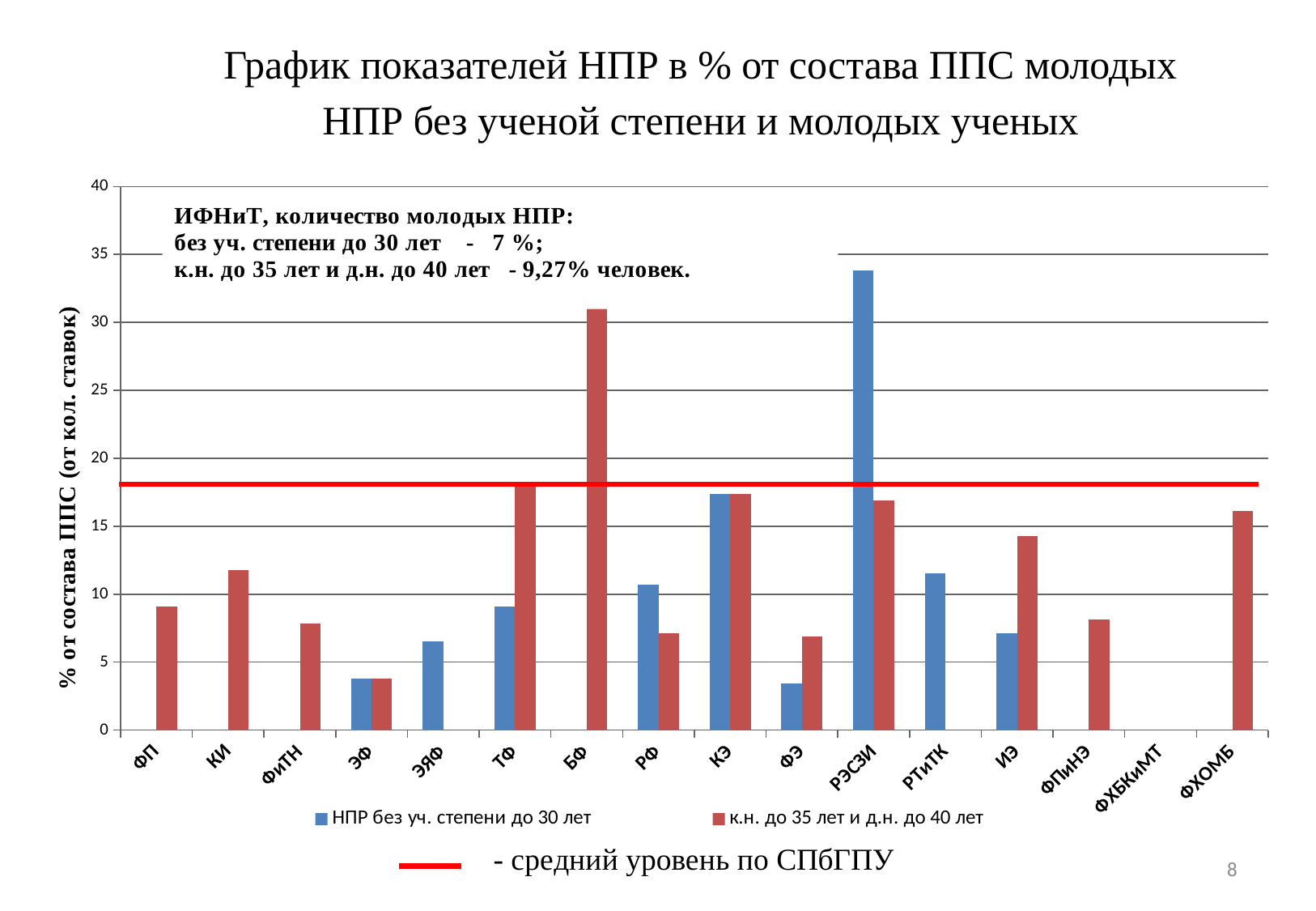
What kind of chart is shown on the slide? bar chart For РФ, which series has the larger value: 'НПР без уч. степени до 30 лет' or 'к.н. до 35 лет и д.н. до 40 лет'? НПР без уч. степени до 30 лет Is the value for РЭСЗИ in the series 'НПР без уч. степени до 30 лет' greater or less than 30? greater Is the value for ФХОМБ in the series 'к.н. до 35 лет и д.н. до 40 лет' greater or less than 20? less Which category has the highest value for the series 'к.н. до 35 лет и д.н. до 40 лет'? БФ Is the value for КИ in the series 'к.н. до 35 лет и д.н. до 40 лет' greater or less than 10? greater What does the red horizontal line on the chart represent, according to the legend? средний уровень по СПбГПУ For ТФ, which series has the larger value: 'НПР без уч. степени до 30 лет' or 'к.н. до 35 лет и д.н. до 40 лет'? к.н. до 35 лет и д.н. до 40 лет How many series does the legend below the chart list? 2 How many categories are shown along the x axis? 16 Which category has the highest value for the series 'НПР без уч. степени до 30 лет'? РЭСЗИ